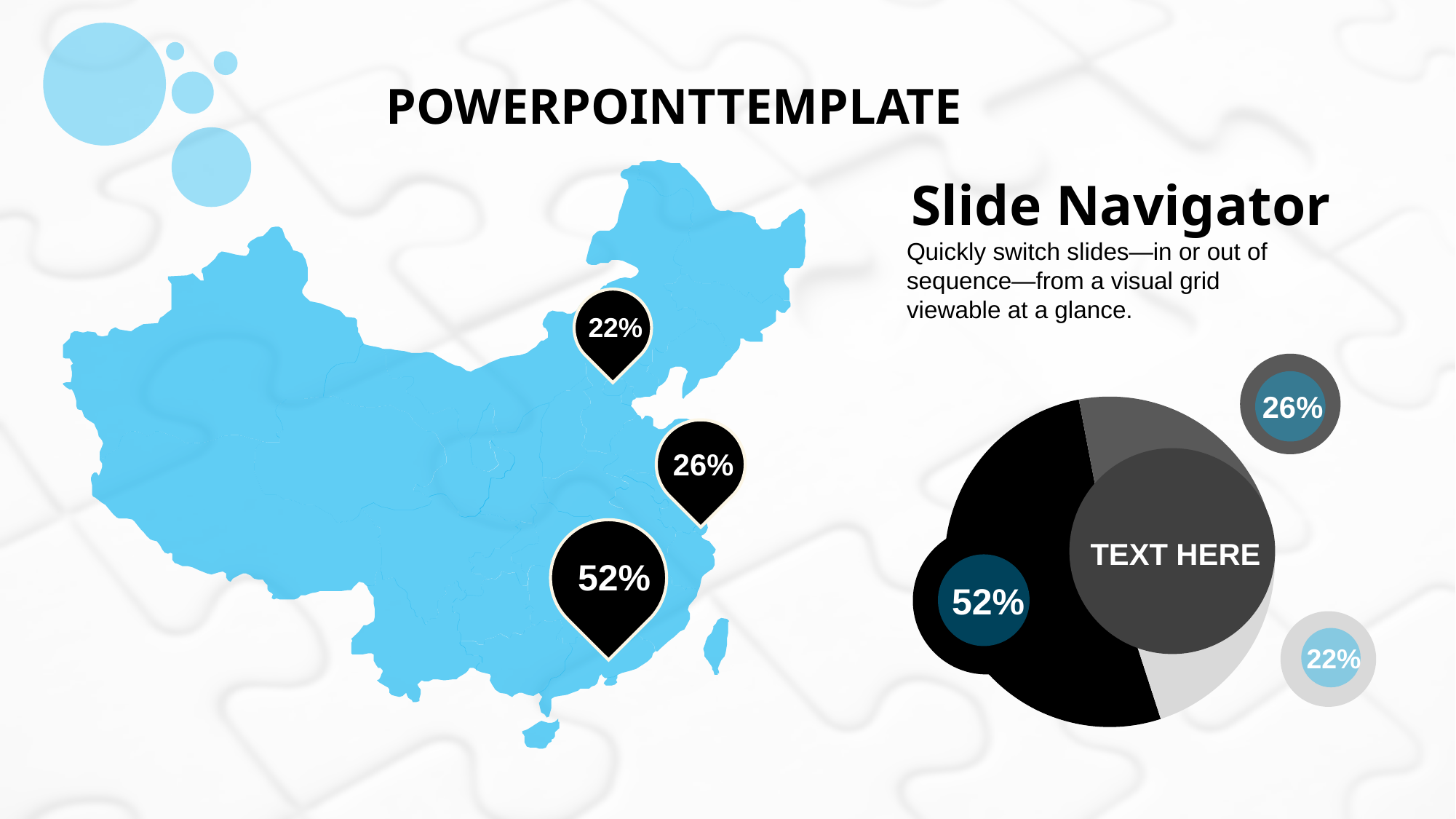
In the pie chart on the right, what percentage is labelled for the dark grey slice? 26% What text is written in the centre of the pie chart on the right? TEXT HERE In the pie chart on the right, which slice has the largest share? the black slice (52%) In the pie chart on the right, what percentage is labelled for the light grey slice? 22% How many slices does the pie chart on the right have? 3 On the map of China on the left, what percentage is shown on the southernmost pin? 52% In the pie chart on the right, what percentage is labelled for the black slice? 52% In the pie chart on the right, which slice has the smallest share? the light grey slice (22%) What kind of chart is shown on the right side of the slide? pie chart In the pie chart on the right, what do the three labelled percentages add up to? 100% In the pie chart on the right, what is the difference between the black slice and the dark grey slice? 26 percentage points In the pie chart on the right, which is larger: the dark grey slice or the light grey slice? the dark grey slice